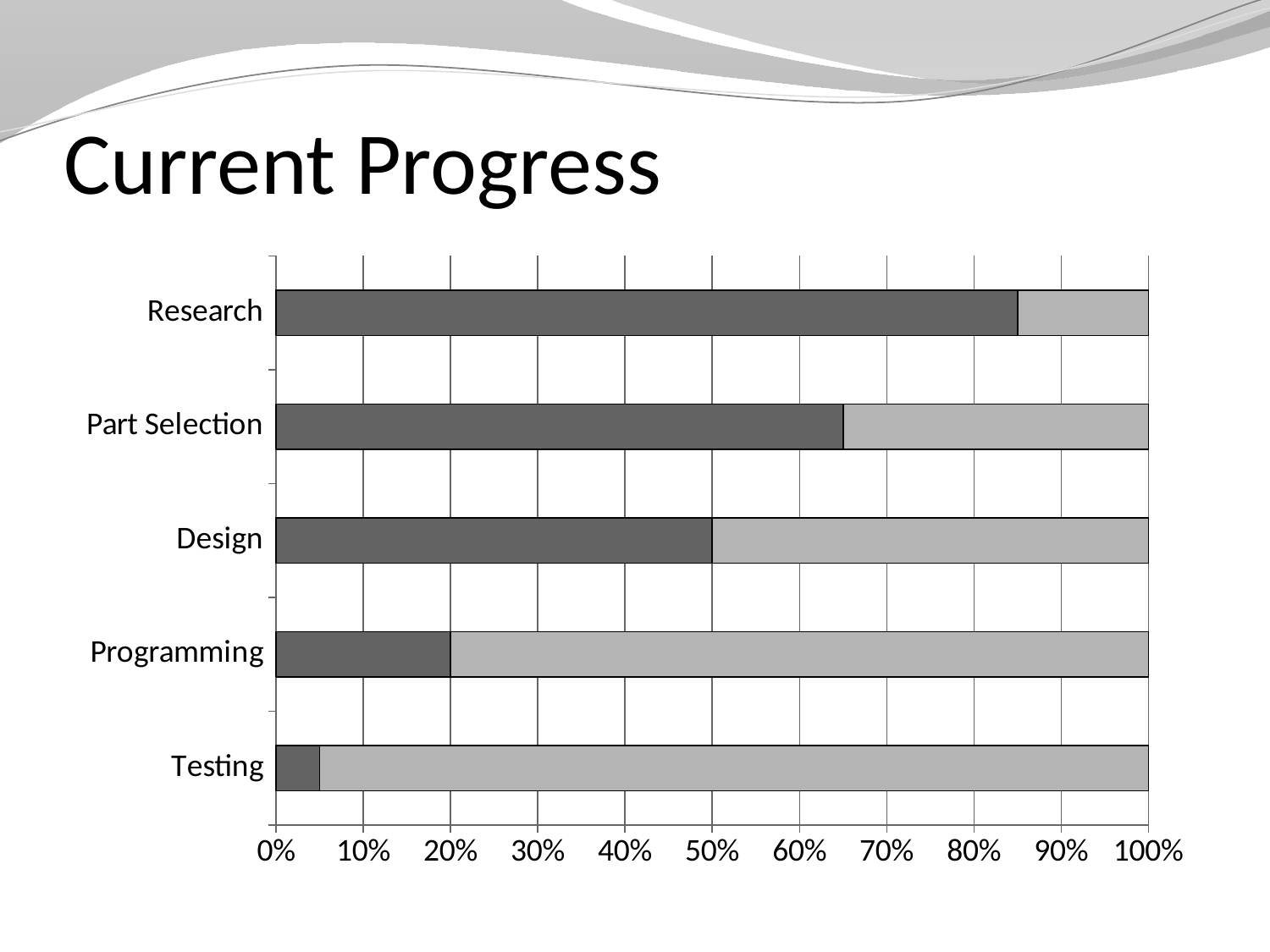
Which has a larger dark segment, Part Selection or Design? Part Selection How many categories are shown on the chart? 5 Is the dark segment for Research greater or less than 80%? greater At what value does the dark segment for Programming end? 20% Is the dark segment for Testing greater or less than 10%? less What is the title of the slide containing the chart? Current Progress At what value does the dark segment for Design end? 50% Is the dark segment for Part Selection greater or less than 60%? greater What is the total length of each stacked bar on the chart? 100% What kind of chart is shown on the slide? bar chart Which category has the smallest dark (completed) segment? Testing Which category has the largest dark (completed) segment? Research